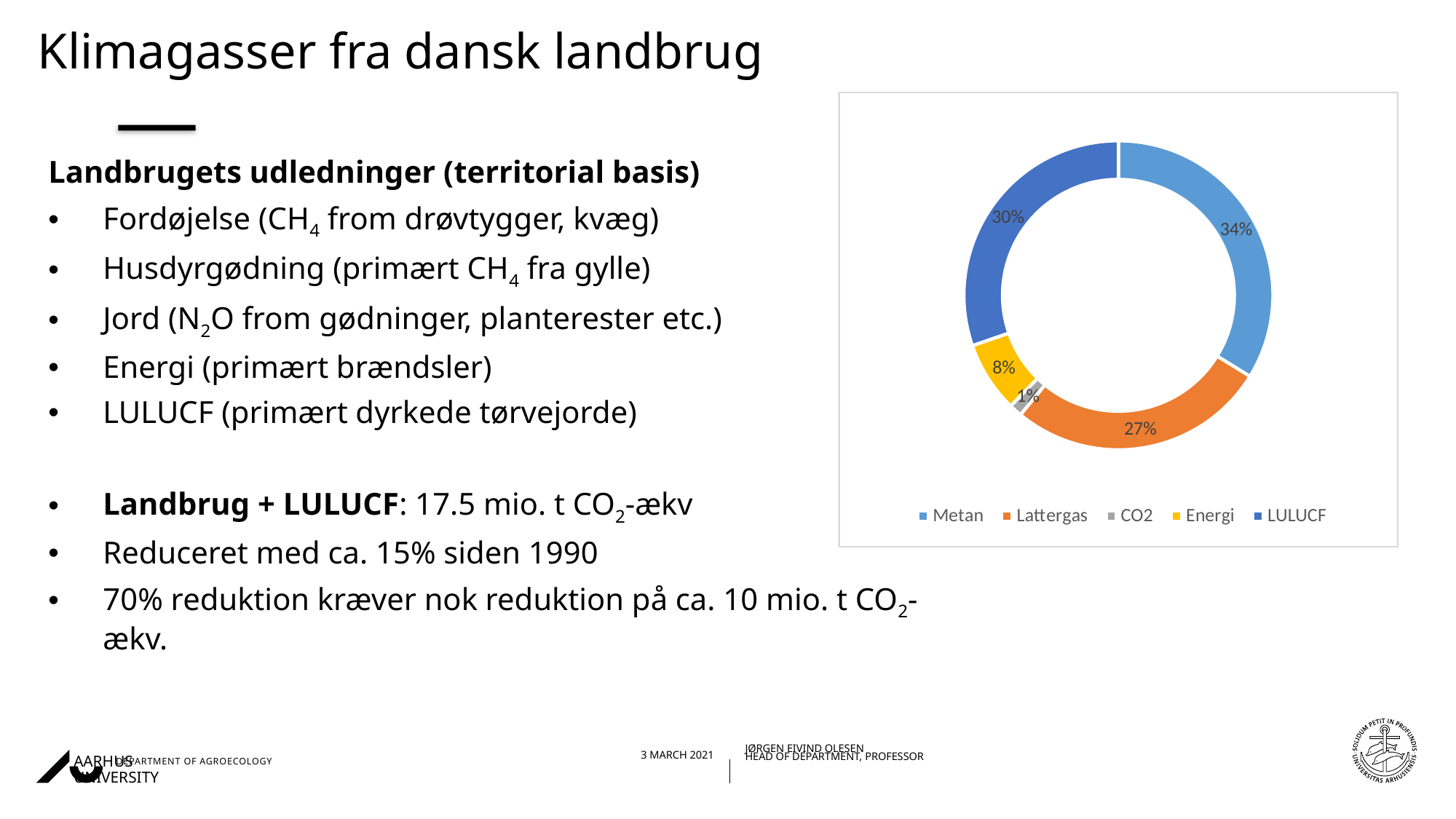
Which colour represents Energi in the chart? Yellow What share of the doughnut chart does Metan account for? 34% What type of chart is shown on the slide? Doughnut chart What is the difference in percentage points between the Metan and Lattergas shares? 7 What share of the doughnut chart does Energi account for? 8% Which category has the smallest share in the doughnut chart? CO2 What share of the doughnut chart does LULUCF account for? 30% What share of the doughnut chart does Lattergas account for? 27% How many categories does the doughnut chart show? 5 Which category has the largest share in the doughnut chart? Metan What share of the doughnut chart does CO2 account for? 1% Which has a larger share, LULUCF or Lattergas? LULUCF